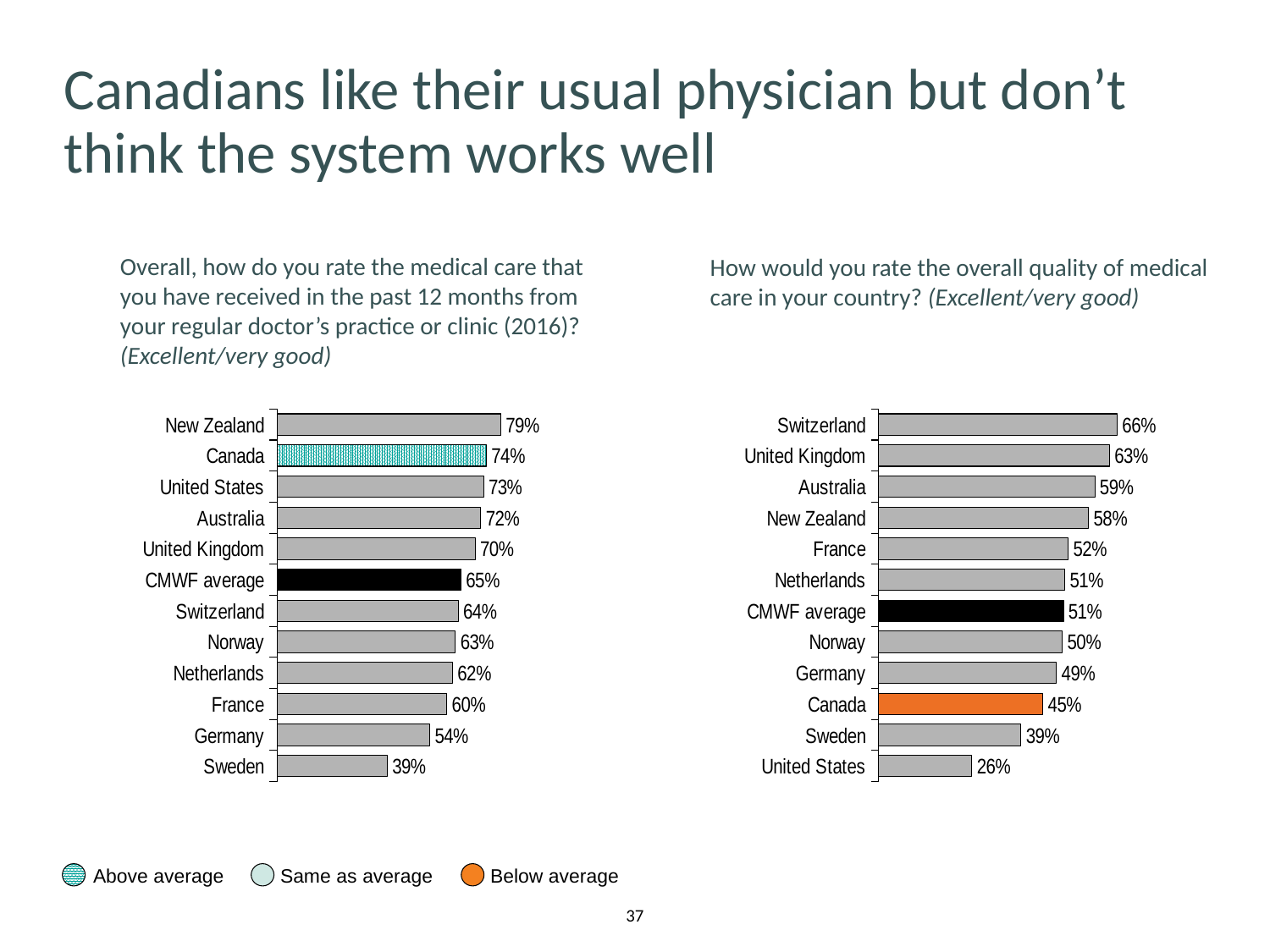
In the left chart, what is the difference between Canada and the CMWF average? 9 percentage points In the left chart, which country has the highest value? New Zealand In the right chart, which is larger, the value for Australia or the value for France? Australia In the right chart, which country has the lowest value? United States According to the legend at the bottom of the slide, what does the orange colour indicate? Below average In the right chart (overall quality of medical care in your country), what is the value for Canada? 45% In the left chart (rating of medical care from regular doctor's practice), what is the value for Canada? 74% In the left chart, how many bars are plotted? 12 What type of chart is used on the right side of the slide? Bar chart In the right chart, what is the value for the CMWF average? 51% In the right chart, what is the difference between Switzerland and the United States? 40 percentage points In the left chart, what is the value for Sweden? 39%